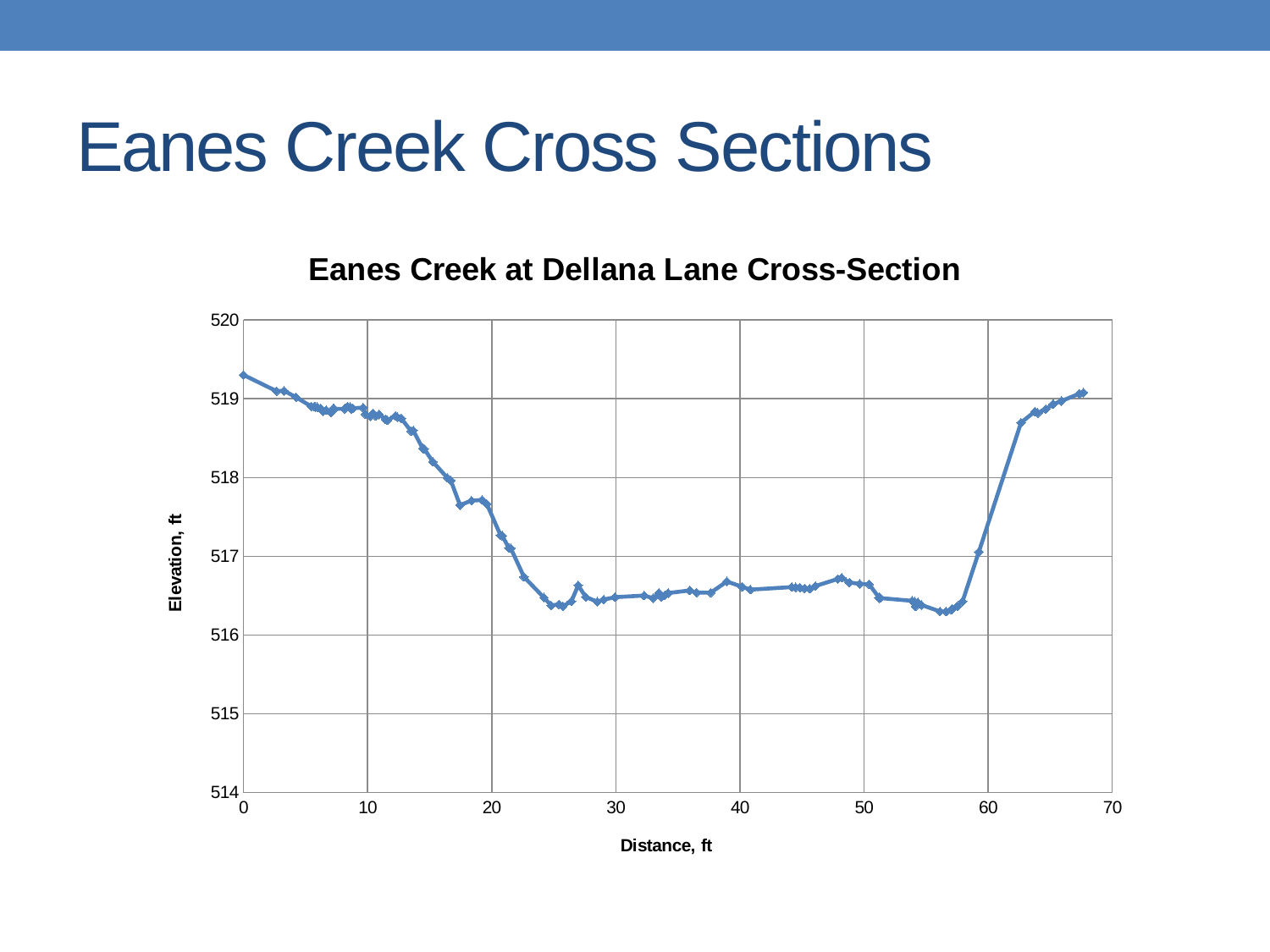
What is the title of the chart? Eanes Creek at Dellana Lane Cross-Section Is the elevation at a distance of 50 ft greater or less than 517? less What is the label of the vertical axis of the chart? Elevation, ft Is the elevation at a distance of 10 ft greater or less than 518? greater Is the elevation at a distance of 0 ft greater or less than 519? greater What kind of chart is shown on the slide? line chart Does the elevation rise or fall as distance increases from 0 ft to 25 ft? fall Does the elevation rise or fall as distance increases from 58 ft to 68 ft? rise Which has the higher elevation: the point at a distance of 0 ft or the point at a distance of 30 ft? 0 ft